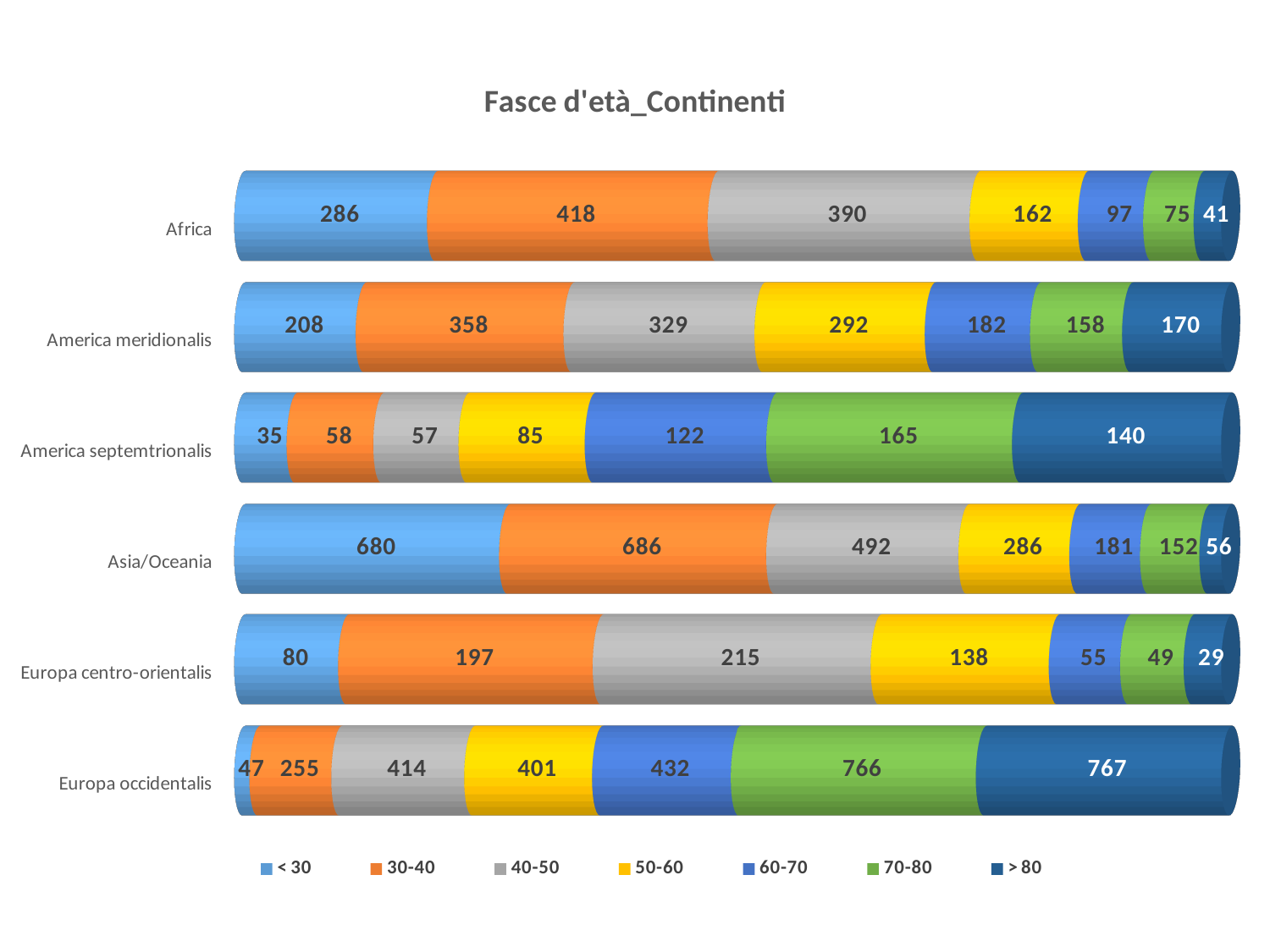
What is the total of all age groups for America septemtrionalis? 662 What is the value for the > 80 age group in Europa occidentalis? 767 What is the value for the 60-70 age group in America septemtrionalis? 122 How many continents are shown on the chart? 6 Which continent has the lowest value for the 40-50 age group? America septemtrionalis Which continent has the highest value for the < 30 age group? Asia/Oceania How many age groups does the legend list? 7 What is the difference between the 30-40 and < 30 values for Asia/Oceania? 6 What is the title of the chart? Fasce d'età_Continenti Which is larger: the 70-80 value for Europa occidentalis or the 70-80 value for America meridionalis? Europa occidentalis What kind of chart is this? Stacked bar chart What is the value for the 30-40 age group in Africa? 418